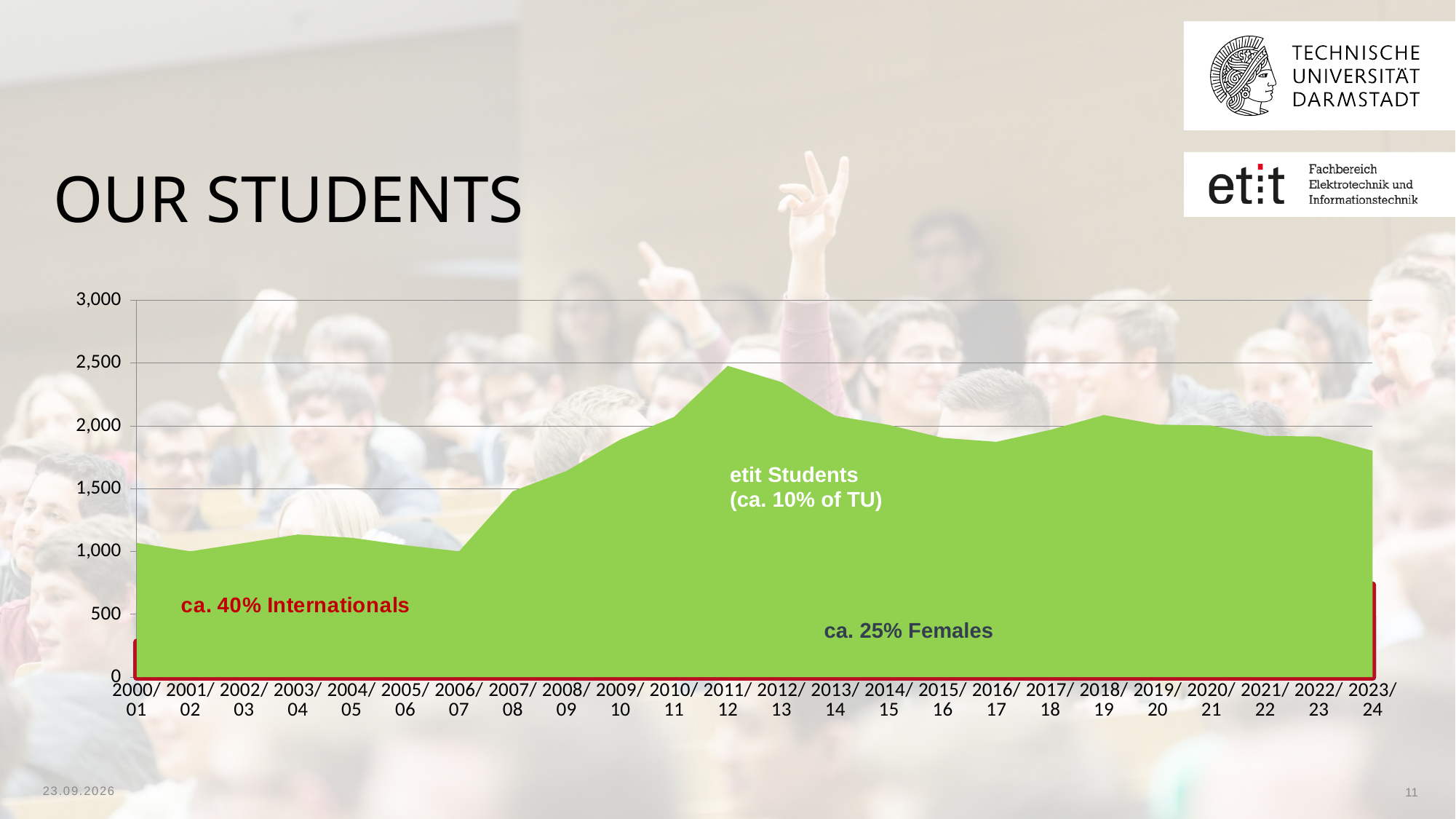
Is the value for 2006/07 greater or less than 1,500? less Do the values rise or fall from 2011/12 to 2016/17? fall Is the value for 2011/12 greater or less than 2,000? greater What kind of chart is shown on the slide? Area chart Do the values rise or fall from 2006/07 to 2011/12? rise Is the value for 2023/24 greater or less than 2,000? less Which has more etit students, 2006/07 or 2007/08? 2007/08 Which academic year has the highest number of etit students? 2011/12 Which has more etit students, 2000/01 or 2011/12? 2011/12 According to the annotation on the chart, what share of TU students are etit students? ca. 10% How many academic years are shown on the x axis of the chart? 24